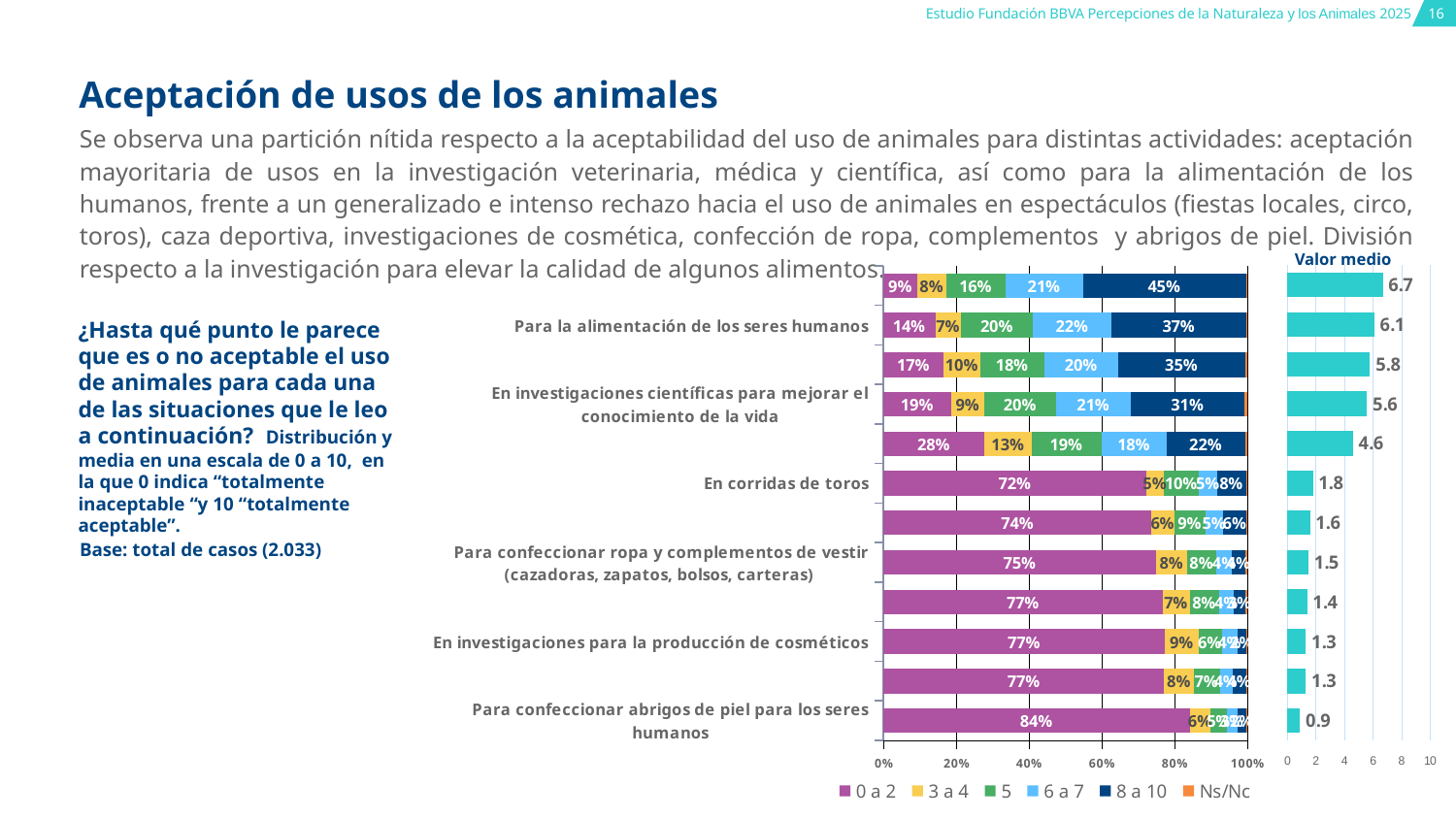
In the 'Valor medio' chart, what is the mean value for 'Para confeccionar abrigos de piel para los seres humanos'? 0.9 In the 'Valor medio' chart, is the mean for 'En investigaciones científicas para mejorar el conocimiento de la vida' greater or less than 4? greater In the distribution chart, what percentage of respondents gave '0 a 2' for 'Para confeccionar abrigos de piel para los seres humanos'? 84% In the distribution chart, what percentage of respondents gave '0 a 2' for 'En investigaciones científicas para mejorar el conocimiento de la vida'? 19% In the distribution chart, what is the difference in the '0 a 2' share between 'Para confeccionar abrigos de piel para los seres humanos' and 'En corridas de toros'? 12 percentage points Which labelled situation has the lowest mean value in the 'Valor medio' chart? Para confeccionar abrigos de piel para los seres humanos How many series does the legend of the distribution chart list? 6 How many bars (situations) are plotted in the distribution chart? 12 What kind of chart is used to show the distribution of responses on the slide? Stacked bar chart In the distribution chart, what percentage of respondents gave '8 a 10' for 'Para la alimentación de los seres humanos'? 37% In the 'Valor medio' chart, what is the mean value for 'Para la alimentación de los seres humanos'? 6.1 In the 'Valor medio' chart, what is the mean value for 'En corridas de toros'? 1.8